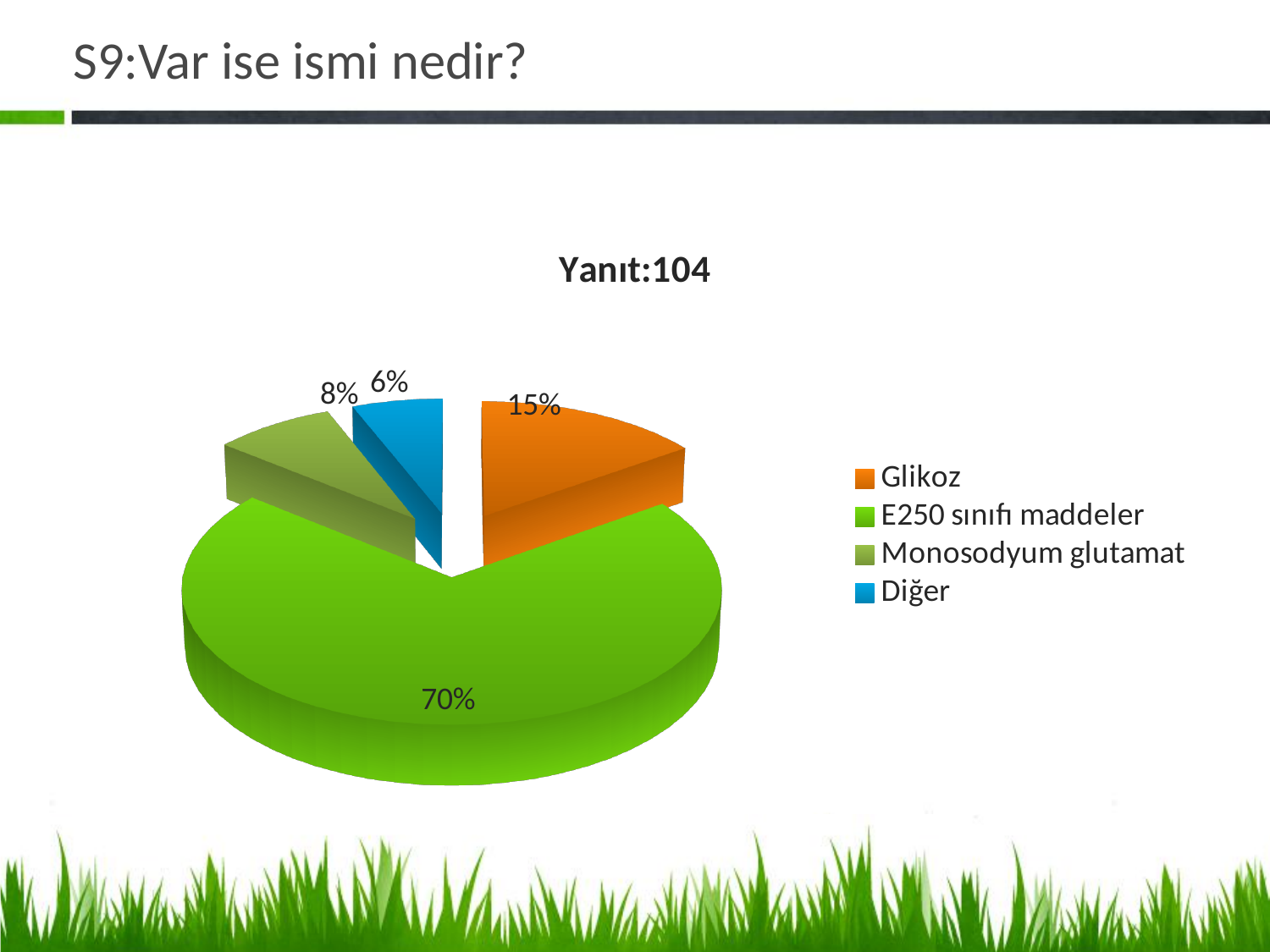
What is the difference in percentage points between the E250 sınıfı maddeler slice and the Glikoz slice? 55% What percentage share does the E250 sınıfı maddeler slice have? 70% Which category has the largest slice of the pie? E250 sınıfı maddeler Which category has the smallest slice of the pie? Diğer What is the chart's title? Yanıt:104 What percentage share does the Diğer slice have? 6% What kind of chart is shown on the slide? pie chart What percentage share does the Monosodyum glutamat slice have? 8% Which colour represents the Diğer category in the legend? blue Which slice is larger, Glikoz or Monosodyum glutamat? Glikoz How many categories does the pie chart show? 4